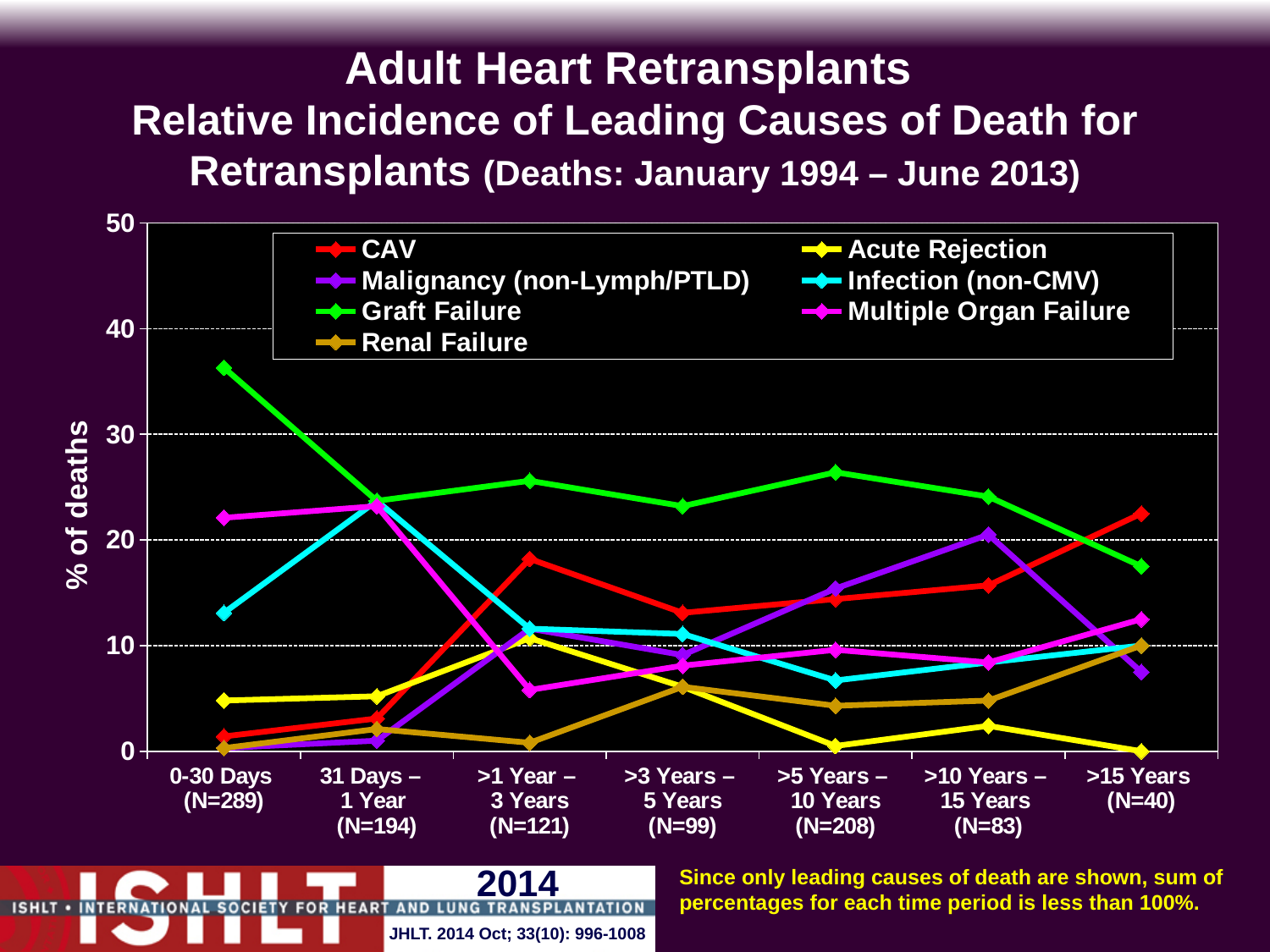
Is the value for CAV in the >15 Years period greater or less than 20? greater What is the label on the y axis? % of deaths Which cause of death has the lowest percentage in the >15 Years period? Acute Rejection Does the CAV line rise or fall from the >3 Years – 5 Years period to the >15 Years period? rise How many series does the legend list? 7 In the >10 Years – 15 Years period, which is larger: Malignancy (non-Lymph/PTLD) or CAV? Malignancy (non-Lymph/PTLD) Is the value for Graft Failure in the 0-30 Days period greater or less than 30? greater Which cause of death has the highest percentage in the 0-30 Days period? Graft Failure Is the value for Multiple Organ Failure in the 0-30 Days period greater or less than 20? greater How many time periods are shown along the x axis? 7 What kind of chart is shown on the slide? line chart What is the N shown for the >5 Years – 10 Years period? N=208